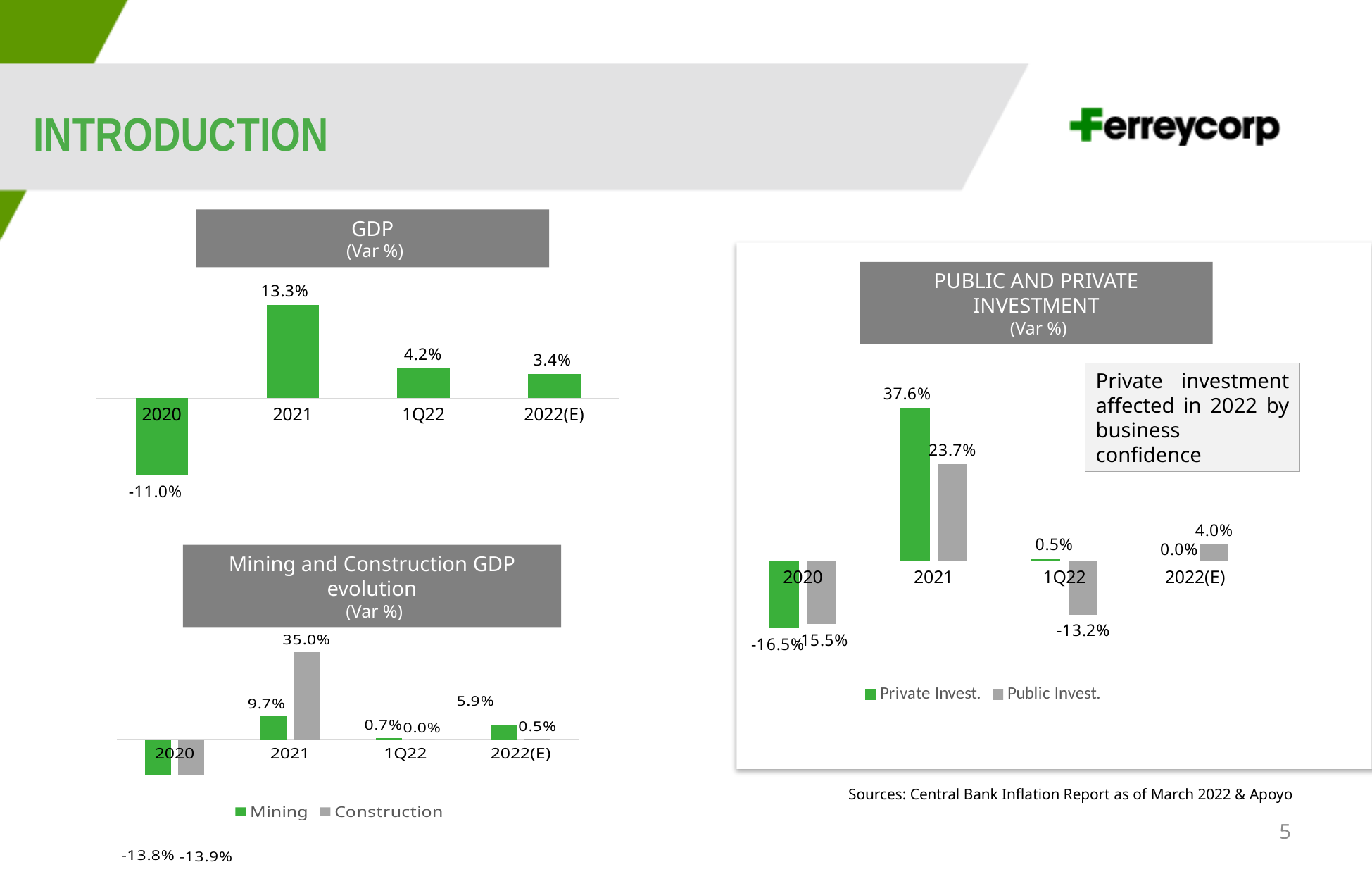
In the Mining and Construction GDP evolution chart, what is the Mining value for 2022(E)? 5.9% In the Public and Private Investment chart, what is the Private Invest. value for 2021? 37.6% What kind of chart is the Public and Private Investment chart? Bar chart In the GDP (Var %) chart, how many categories are shown on the x axis? 4 In the GDP (Var %) chart, what is the value for 2020? -11.0% In the Mining and Construction GDP evolution chart, what is the Construction value for 2021? 35.0% In the GDP (Var %) chart, what is the difference between the 2021 value and the 2022(E) value? 9.9% In the GDP (Var %) chart, what is the value for 2021? 13.3% In the Public and Private Investment chart, what is the Public Invest. value for 1Q22? -13.2% In the GDP (Var %) chart, which category has the lowest value? 2020 In the Mining and Construction GDP evolution chart, which is larger for 2021: Mining or Construction? Construction In the Mining and Construction GDP evolution chart, how many series does the legend list? 2